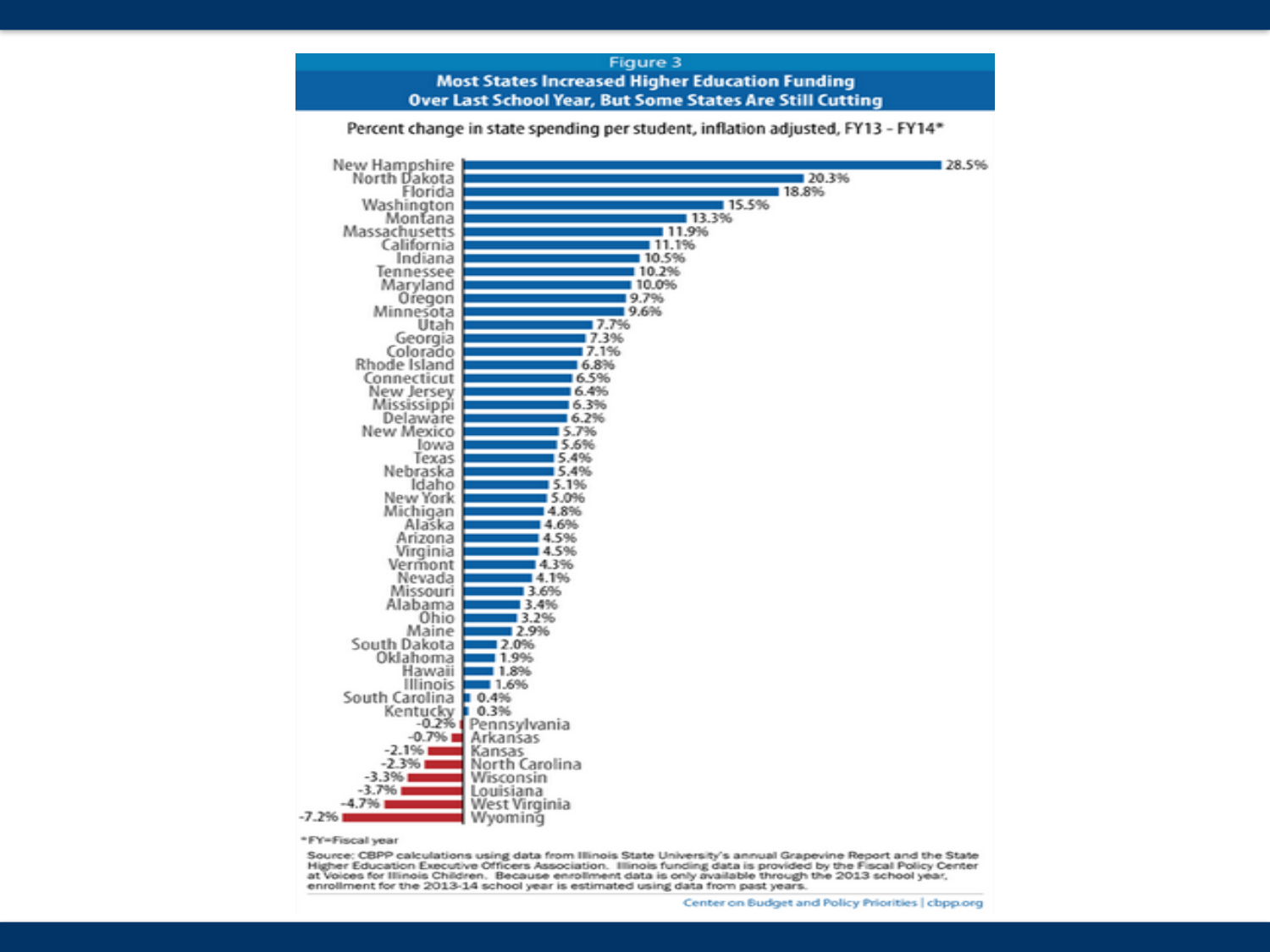
What kind of chart is shown on the slide? Bar chart How many states show a negative percent change in state spending per student? 8 Which state has a larger percent change, Washington or Montana? Washington What is the percent change in state spending per student for Illinois? 1.6% How many states are shown in the chart? 50 What is the percent change in state spending per student for Texas? 5.4% What is the percent change in state spending per student for Wyoming? -7.2% What is the title of Figure 3? Most States Increased Higher Education Funding Over Last School Year, But Some States Are Still Cutting Which state has the lowest percent change in state spending per student? Wyoming Which state has the highest percent change in state spending per student? New Hampshire What is the percent change in state spending per student for New Hampshire? 28.5% What is the difference between the percent change for North Dakota and Florida? 1.5%